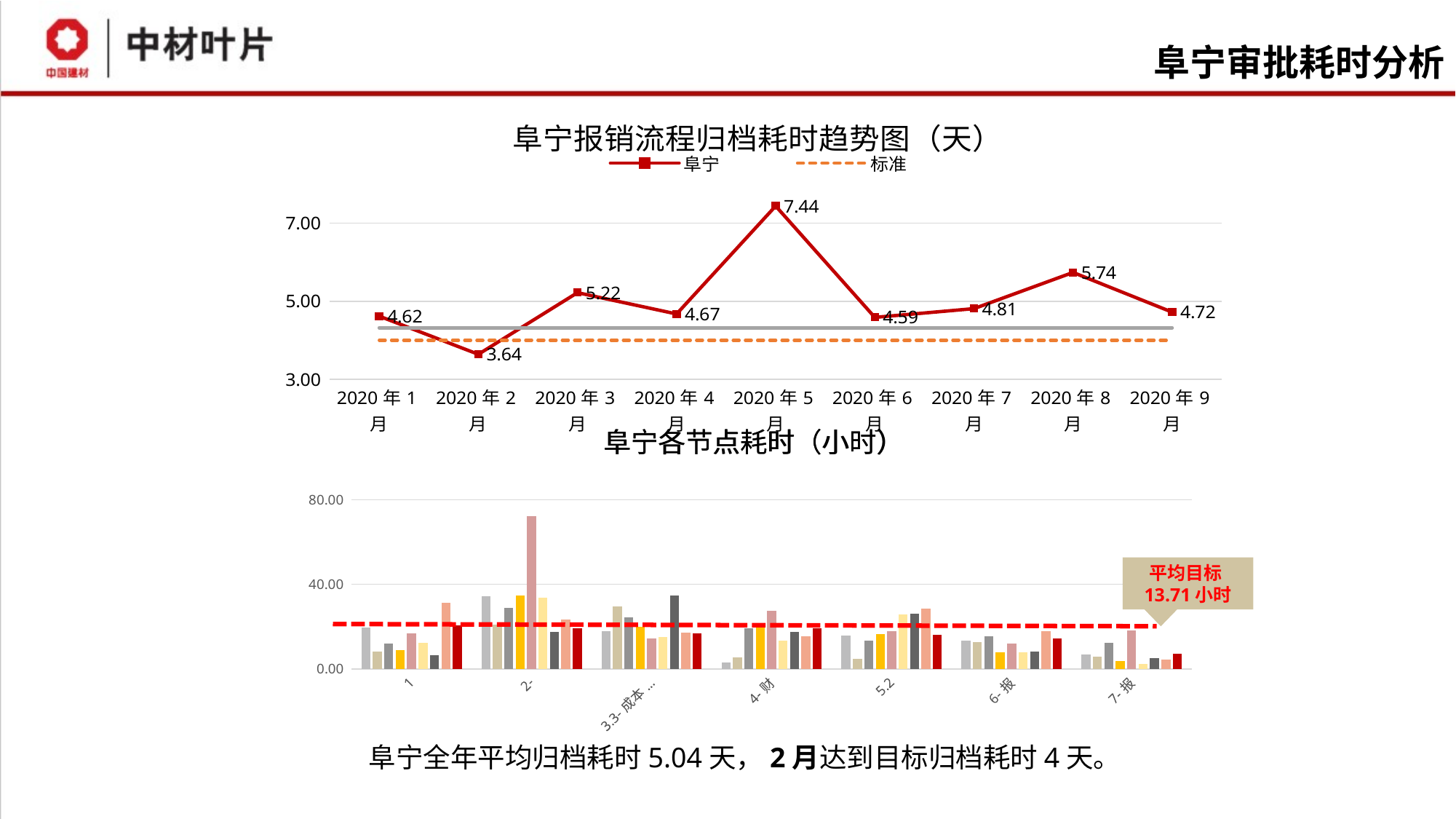
In the bottom chart 阜宁各节点耗时（小时）, is the tallest bar in the category 2- greater or less than 40.00? greater In the top chart 阜宁报销流程归档耗时趋势图（天）, what is the value for 2020年2月? 3.64 In the top chart 阜宁报销流程归档耗时趋势图（天）, what is the difference between the values for 2020年5月 and 2020年2月? 3.80 In the top chart 阜宁报销流程归档耗时趋势图（天）, what is the value for 2020年5月? 7.44 In the top chart 阜宁报销流程归档耗时趋势图（天）, how many months are plotted? 9 What kind of chart is the bottom chart 阜宁各节点耗时（小时）? bar chart In the top chart 阜宁报销流程归档耗时趋势图（天）, which is larger, the value for 2020年3月 or 2020年7月? 2020年3月 In the top chart 阜宁报销流程归档耗时趋势图（天）, which month has the lowest value? 2020年2月 In the top chart 阜宁报销流程归档耗时趋势图（天）, how many entries does the legend list? 2 What kind of chart is the top chart 阜宁报销流程归档耗时趋势图（天）? line chart In the top chart 阜宁报销流程归档耗时趋势图（天）, which month has the highest value? 2020年5月 In the top chart 阜宁报销流程归档耗时趋势图（天）, what is the value for 2020年8月? 5.74